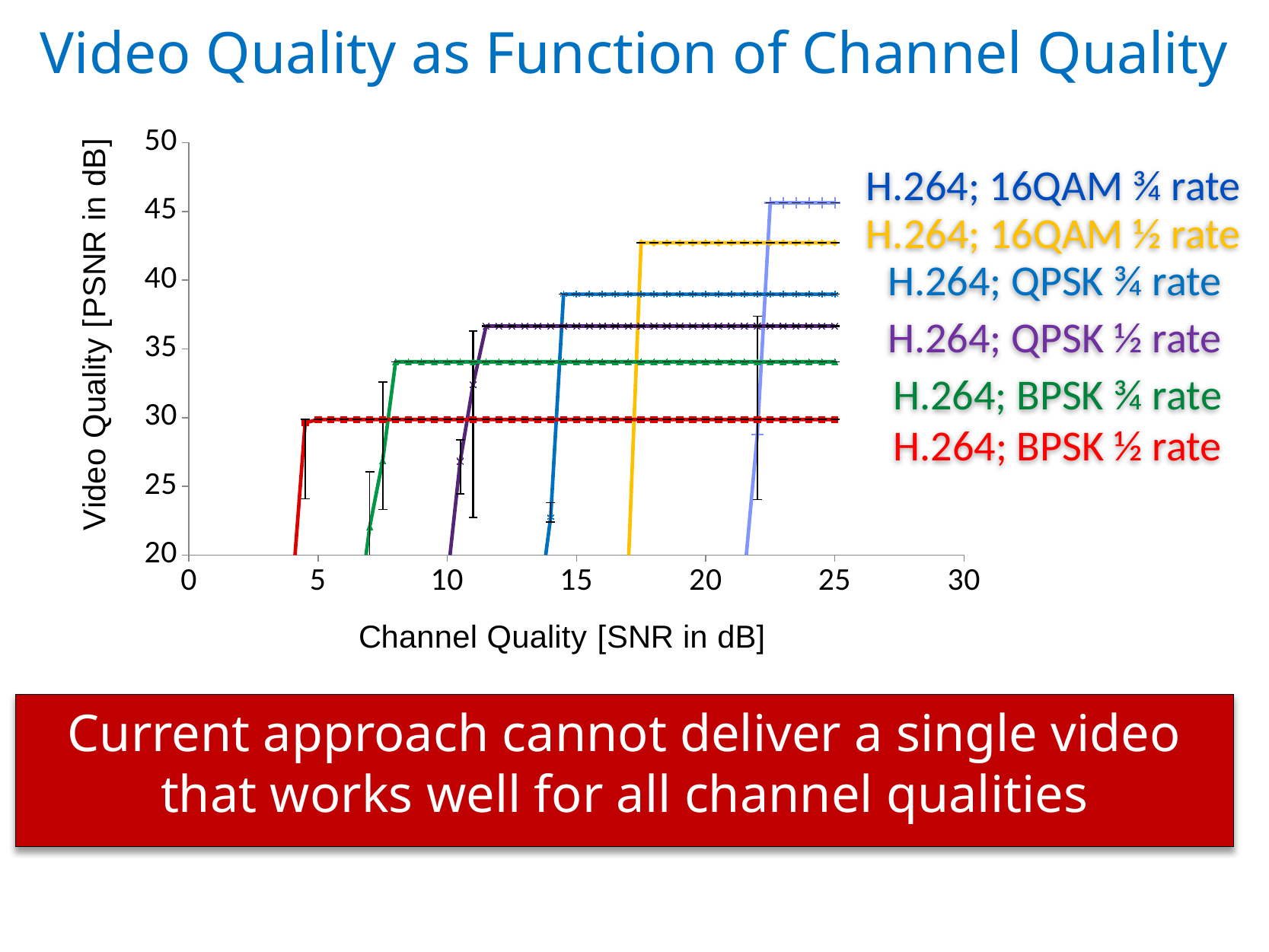
Is the plateau value for H.264; 16QAM ½ rate greater or less than 40? greater Is the plateau value for H.264; QPSK ½ rate greater or less than 35? greater Which series reaches a higher PSNR plateau, H.264; BPSK ¾ rate or H.264; QPSK ¾ rate? H.264; QPSK ¾ rate Is the plateau value for H.264; QPSK ¾ rate greater or less than 40? less What kind of chart is shown on the slide? line chart As channel quality (SNR) increases, does the video quality for each series rise or fall? rise What is the title of the chart? Video Quality as Function of Channel Quality Which series has the lowest video quality (PSNR) plateau? H.264; BPSK ½ rate How many series does the legend list? 6 What is the label of the x axis? Channel Quality [SNR in dB] Which series reaches the highest video quality (PSNR) plateau? H.264; 16QAM ¾ rate